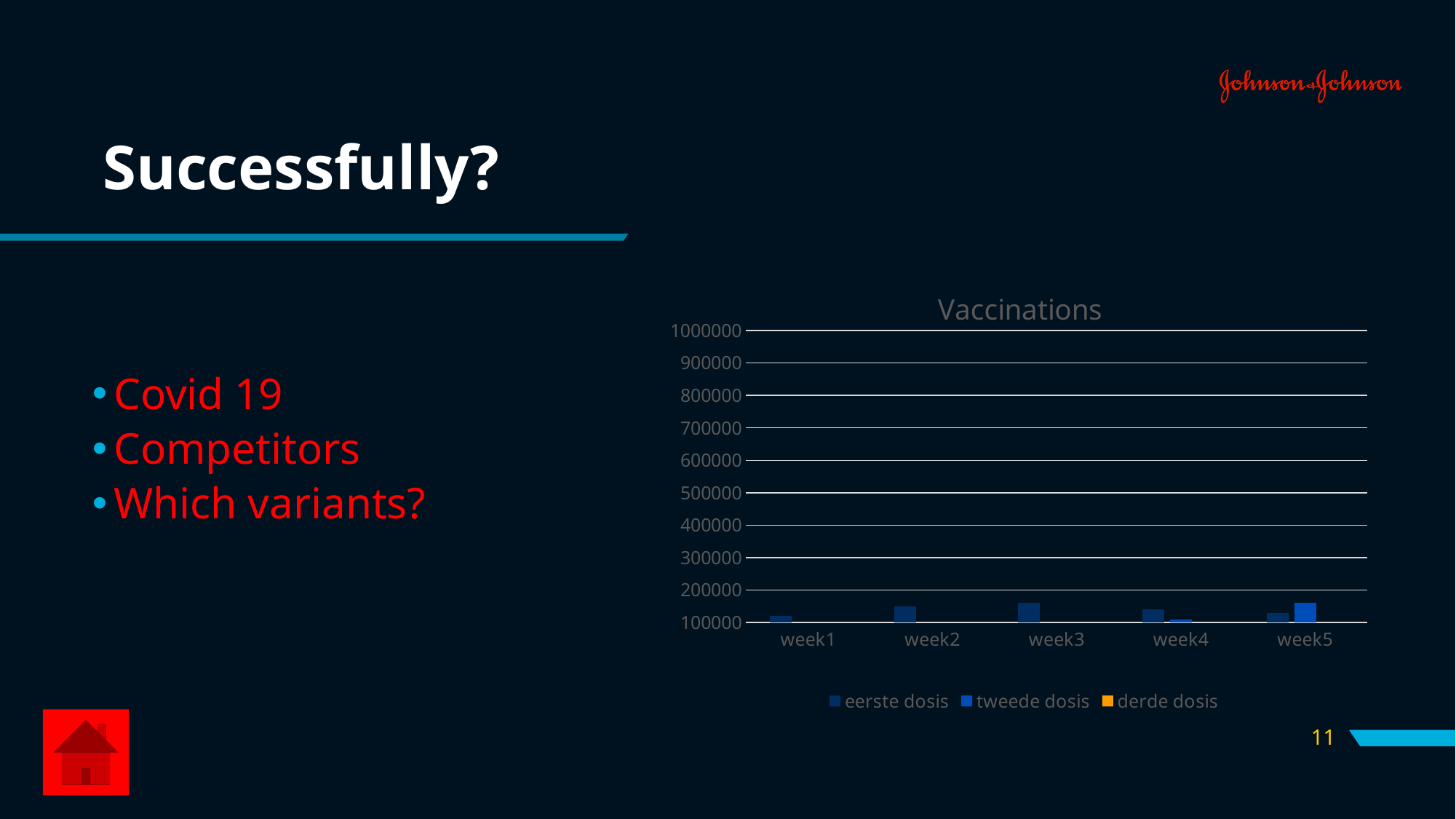
Is the value for eerste dosis in week3 greater or less than 200000? less Is the value for tweede dosis in week5 greater or less than 200000? less Does the value for eerste dosis rise or fall from week1 to week3? rise Which series are listed in the chart legend? eerste dosis, tweede dosis, derde dosis Which week has the highest value for tweede dosis? week5 Which week has the lowest value for eerste dosis? week1 Is the value for eerste dosis in week1 greater or less than 300000? less How many week categories are shown on the x axis of the chart? 5 Which is larger: tweede dosis in week4 or tweede dosis in week5? week5 What is the title of the chart? Vaccinations What kind of chart is shown on the slide? bar chart How many series does the chart legend list? 3